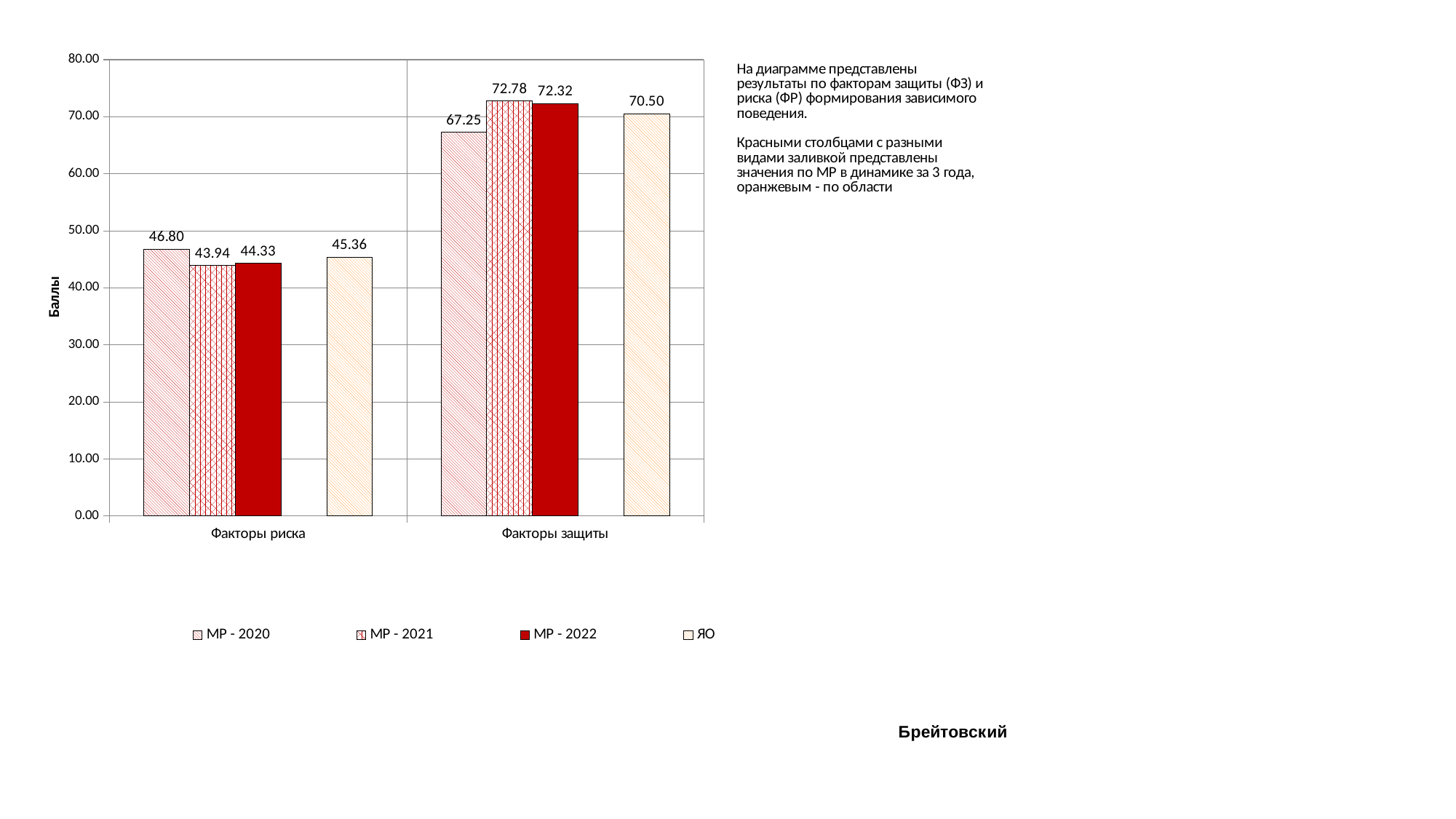
Which is larger in the Факторы риска category: МР - 2020 or ЯО? МР - 2020 How many categories are shown on the x axis? 2 How many series does the legend list? 4 Which series has the highest value in the Факторы защиты category? МР - 2021 What is the value for МР - 2020 in the Факторы риска category? 46.80 What is the difference between the МР - 2021 and МР - 2020 values in the Факторы защиты category? 5.53 What kind of chart is shown on the slide? bar chart What is the value for ЯО in the Факторы защиты category? 70.50 What is the value for МР - 2022 in the Факторы риска category? 44.33 Is the value for МР - 2020 in the Факторы защиты category greater or less than 70.00? less What is the label of the vertical axis? Баллы Which series has the lowest value in the Факторы риска category? МР - 2021